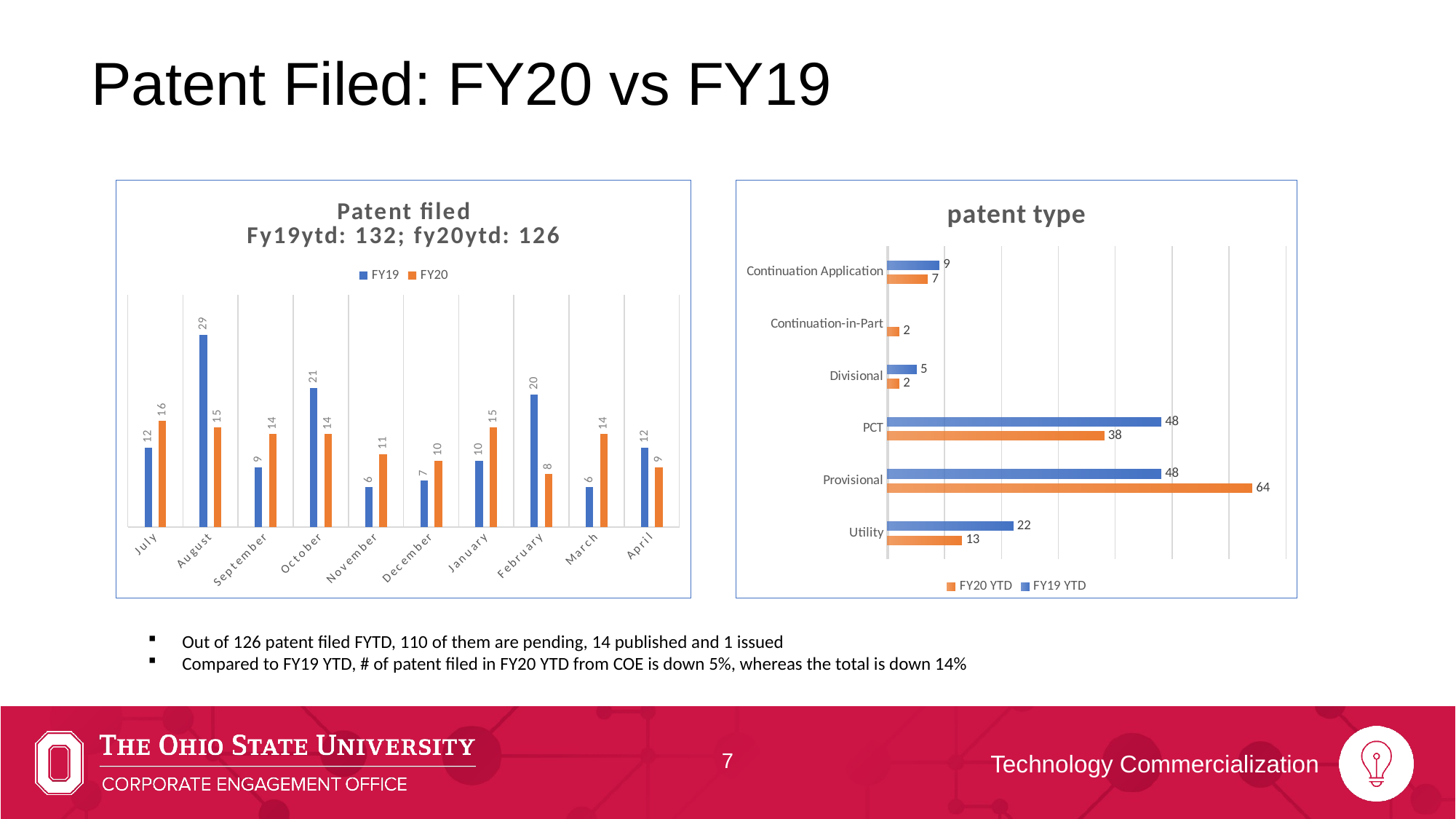
In the 'patent type' chart, how many series does the legend list? 2 In the 'Patent filed' chart, what is the FY20 value for November? 11 In the 'Patent filed' chart, what is the FY19 value for August? 29 In the 'Patent filed' chart, which month has the highest FY19 value? August In the 'patent type' chart, what is the FY19 YTD value for Utility? 22 What kind of chart is the 'patent type' chart? Bar chart In the 'Patent filed' chart, which is larger for March: FY19 or FY20? FY20 In the 'Patent filed' chart, which month has the lowest FY20 value? February In the 'Patent filed' chart, how many months are shown on the x axis? 10 In the 'patent type' chart, what is the FY20 YTD value for Provisional? 64 In the 'patent type' chart, what is the difference between the FY19 YTD and FY20 YTD values for PCT? 10 In the 'Patent filed' chart, what is the difference between the FY19 and FY20 values for October? 7